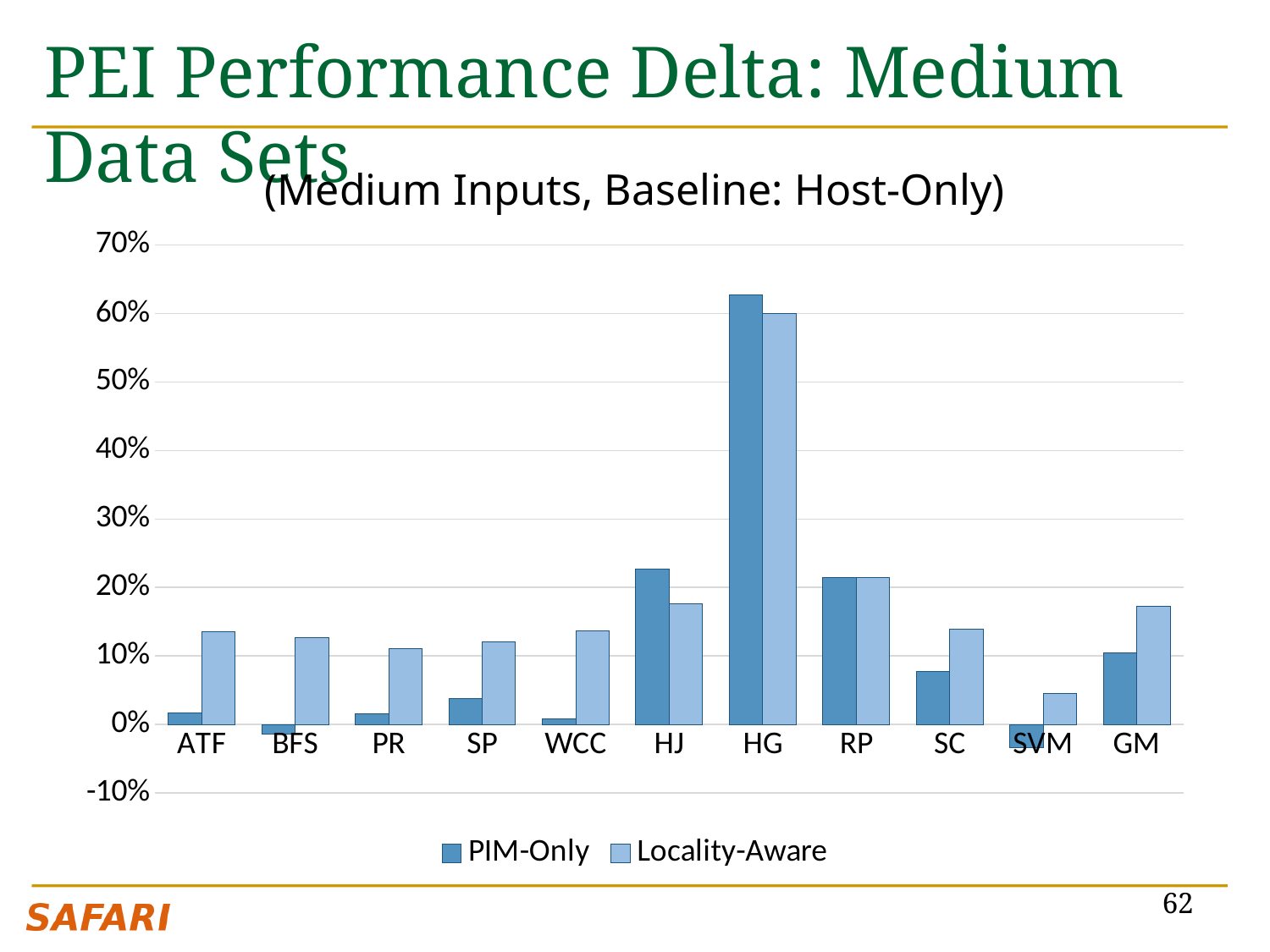
Is the PIM-Only value for HJ greater or less than 20%? greater What kind of chart is shown on the slide? bar chart For ATF, which is larger: the PIM-Only value or the Locality-Aware value? Locality-Aware Which category has the highest Locality-Aware value? HG Is the Locality-Aware value for SVM greater or less than 10%? less How many categories are shown on the x axis? 11 For HJ, which is larger: the PIM-Only value or the Locality-Aware value? PIM-Only Which category has the highest PIM-Only value? HG How many series does the legend list? 2 Which category has the lowest Locality-Aware value? SVM What is the chart's title? (Medium Inputs, Baseline: Host-Only) Is the PIM-Only value for HG greater or less than 60%? greater